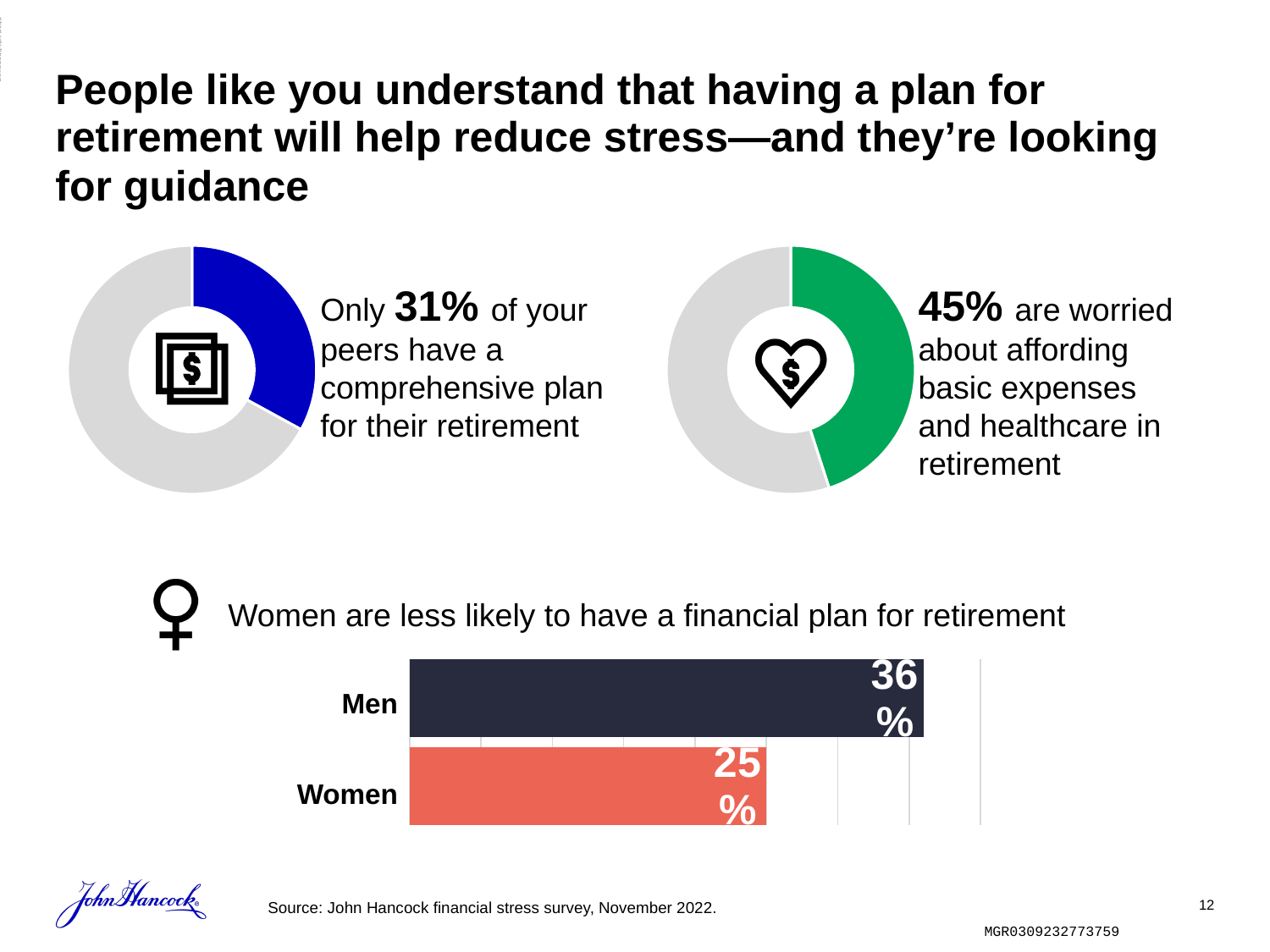
In the donut chart on the right of the slide, what share are worried about affording basic expenses and healthcare in retirement? 45% What kind of chart is used on the left side of the slide to show the 31% figure? donut chart In the bar chart at the bottom of the slide, is the value for Women larger or smaller than the value for Men? smaller In the donut chart on the left of the slide, what share of peers have a comprehensive plan for their retirement? 31% What kind of chart is shown at the bottom of the slide comparing Men and Women? bar chart In the bar chart at the bottom of the slide, which category has the higher value? Men In the bar chart at the bottom of the slide, what is the value for Men? 36% In the bar chart at the bottom of the slide, what colour is the bar for Women? red In the bar chart at the bottom of the slide, what is the difference between the values for Men and Women? 11 percentage points How many categories are shown in the bar chart at the bottom of the slide? 2 In the bar chart at the bottom of the slide, which category has the lower value? Women In the bar chart at the bottom of the slide, what is the value for Women? 25%